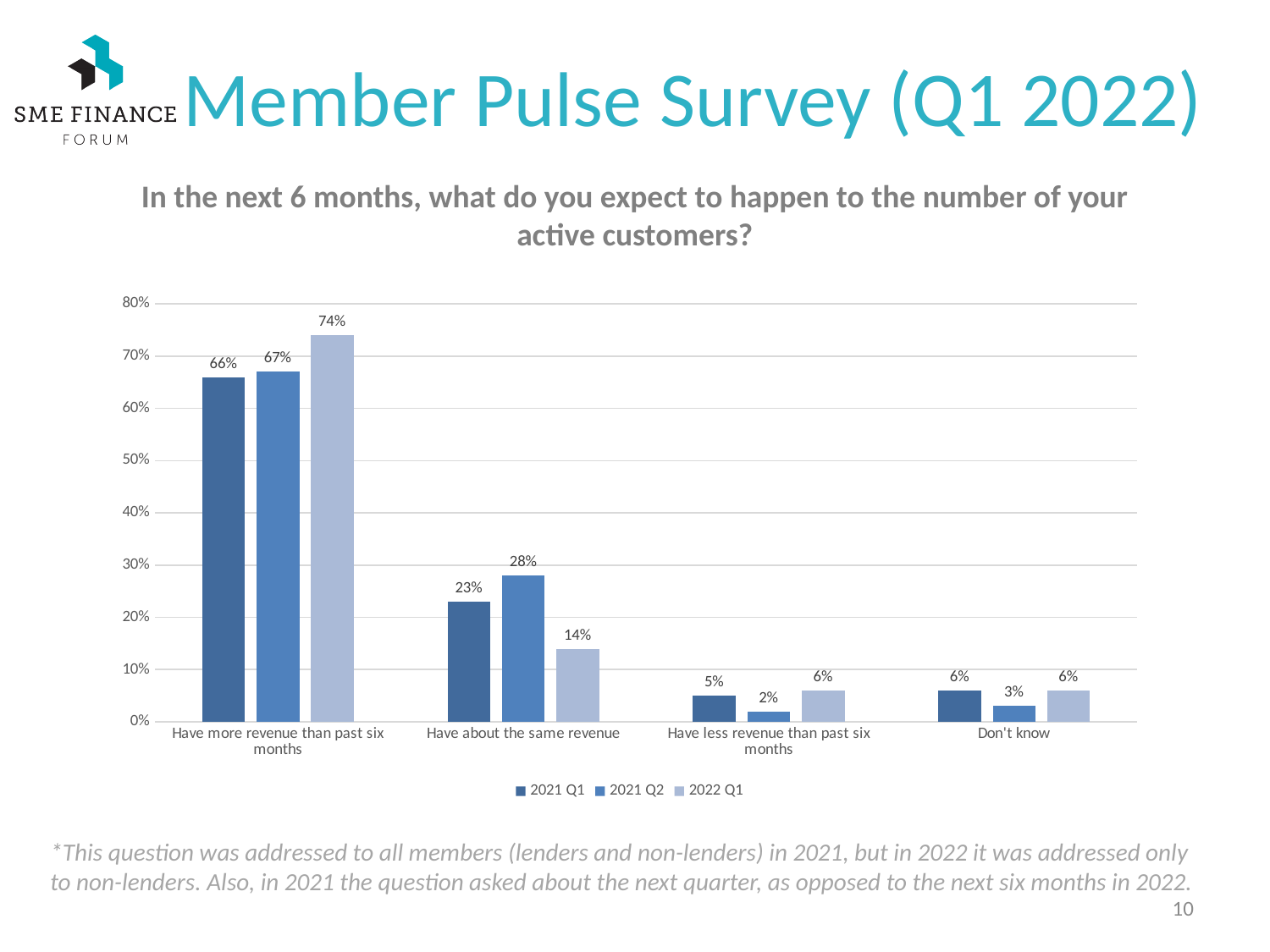
Which is larger in the 'Have about the same revenue' category: 2021 Q1 or 2022 Q1? 2021 Q1 What is the value for 2022 Q1 in the 'Have more revenue than past six months' category? 74% What is the value for 2021 Q2 in the 'Have about the same revenue' category? 28% Across the three series, do the values in the 'Have about the same revenue' category rise or fall from 2021 Q2 to 2022 Q1? Fall What is the value for 2021 Q2 in the 'Have less revenue than past six months' category? 2% How many categories are shown on the x axis? 4 What is the value for 2021 Q1 in the 'Don't know' category? 6% What is the difference between the 2022 Q1 and 2021 Q1 values in the 'Have more revenue than past six months' category? 8% What kind of chart is shown on the slide? Bar chart Which category has the lowest value for the 2021 Q2 series? Have less revenue than past six months How many series does the legend list? 3 Which category has the highest value for the 2021 Q1 series? Have more revenue than past six months